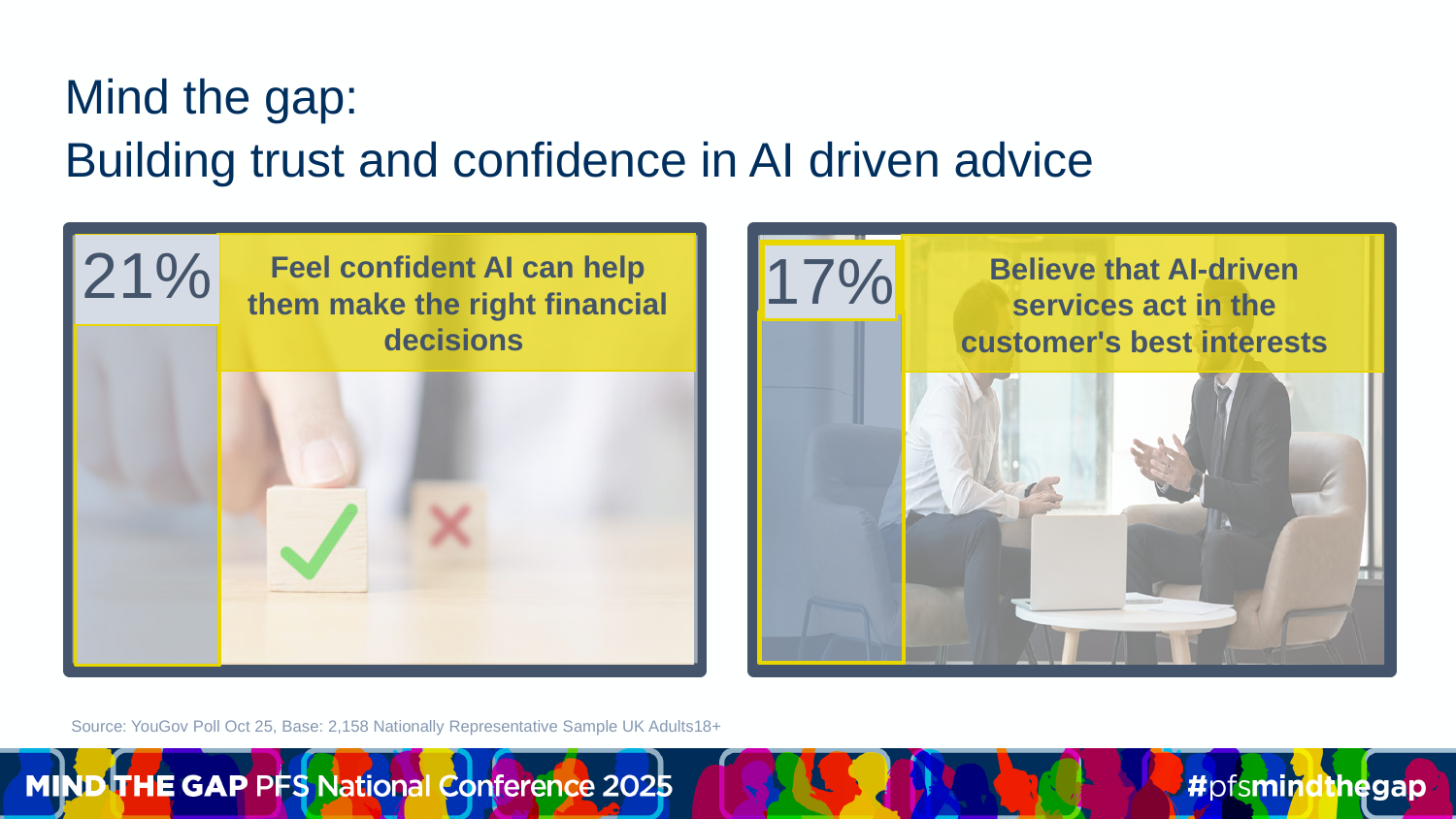
What percentage of respondents believe that AI-driven services act in the customer's best interests? 17% What is the difference in percentage points between the 21% and 17% figures shown on the slide? 4 percentage points Which is larger: the share who feel confident AI can help them make the right financial decisions, or the share who believe AI-driven services act in the customer's best interests? Feel confident AI can help them make the right financial decisions What value is shown in the right panel of the slide? 17% What is the base sample size given in the source note on the slide? 2,158 Which of the two statistics on the slide is the lowest? Believe that AI-driven services act in the customer's best interests (17%) What is the title of the slide? Mind the gap: Building trust and confidence in AI driven advice What percentage of respondents feel confident AI can help them make the right financial decisions? 21% What value is shown in the left panel of the slide? 21% Is the value in the right panel greater or less than 20%? less Which of the two statistics on the slide is the highest? Feel confident AI can help them make the right financial decisions (21%) How many statistic panels are shown on the slide? 2